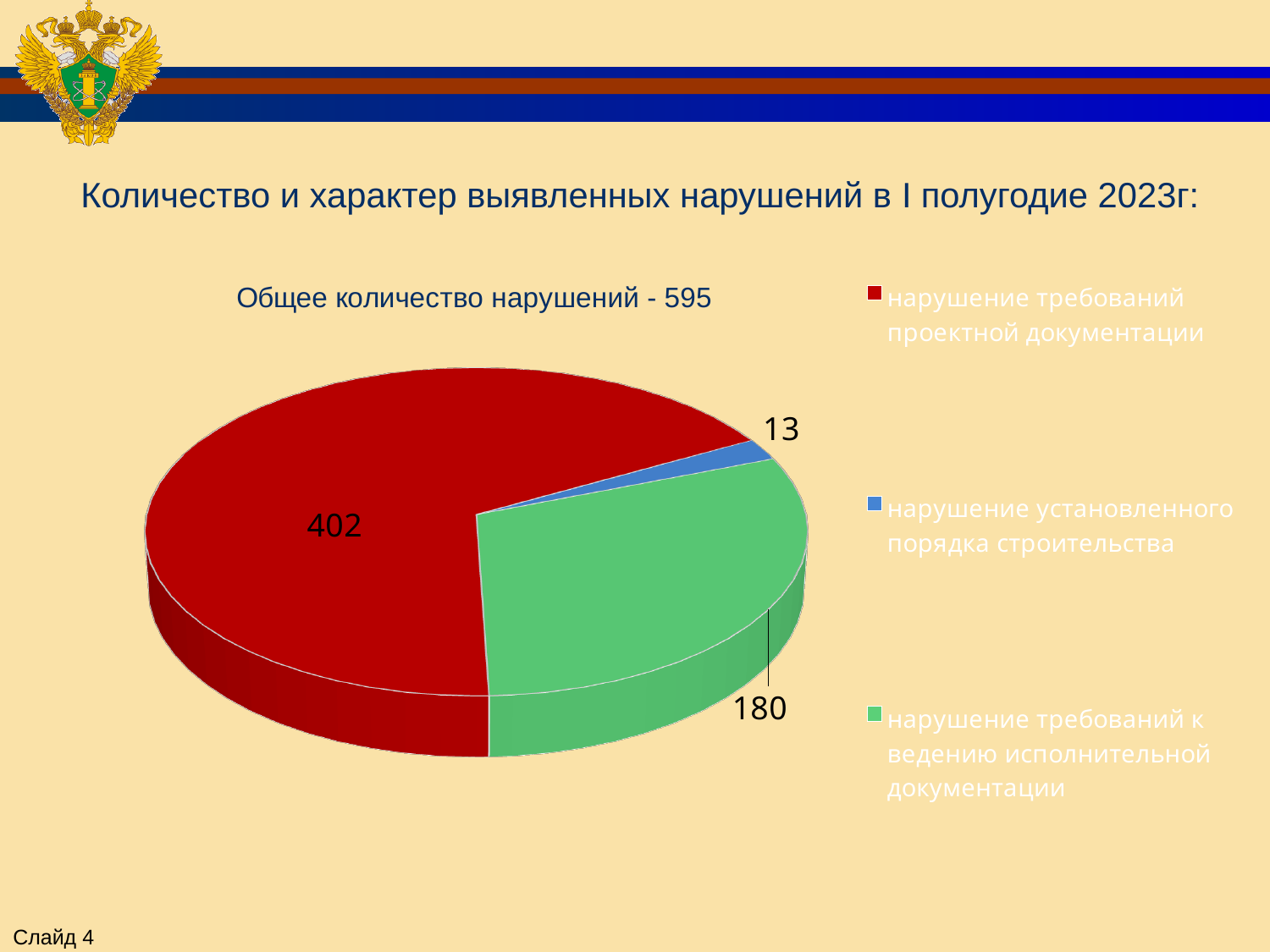
What is the value for 'нарушение установленного порядка строительства' in the pie chart? 13 What total number of violations is stated in the chart title? 595 What is the value for 'нарушение требований к ведению исполнительной документации' in the pie chart? 180 What kind of chart is shown on the slide? pie chart What is the value for 'нарушение требований проектной документации' in the pie chart? 402 What colour is the slice for 'нарушение установленного порядка строительства'? blue What is the difference between the values for 'нарушение требований проектной документации' and 'нарушение требований к ведению исполнительной документации'? 222 How many slices does the pie chart have? 3 Which category has the smallest slice in the pie chart? нарушение установленного порядка строительства How many entries does the legend of the pie chart list? 3 Which category has the largest slice in the pie chart? нарушение требований проектной документации Which is larger: the value for 'нарушение требований к ведению исполнительной документации' or the value for 'нарушение установленного порядка строительства'? нарушение требований к ведению исполнительной документации